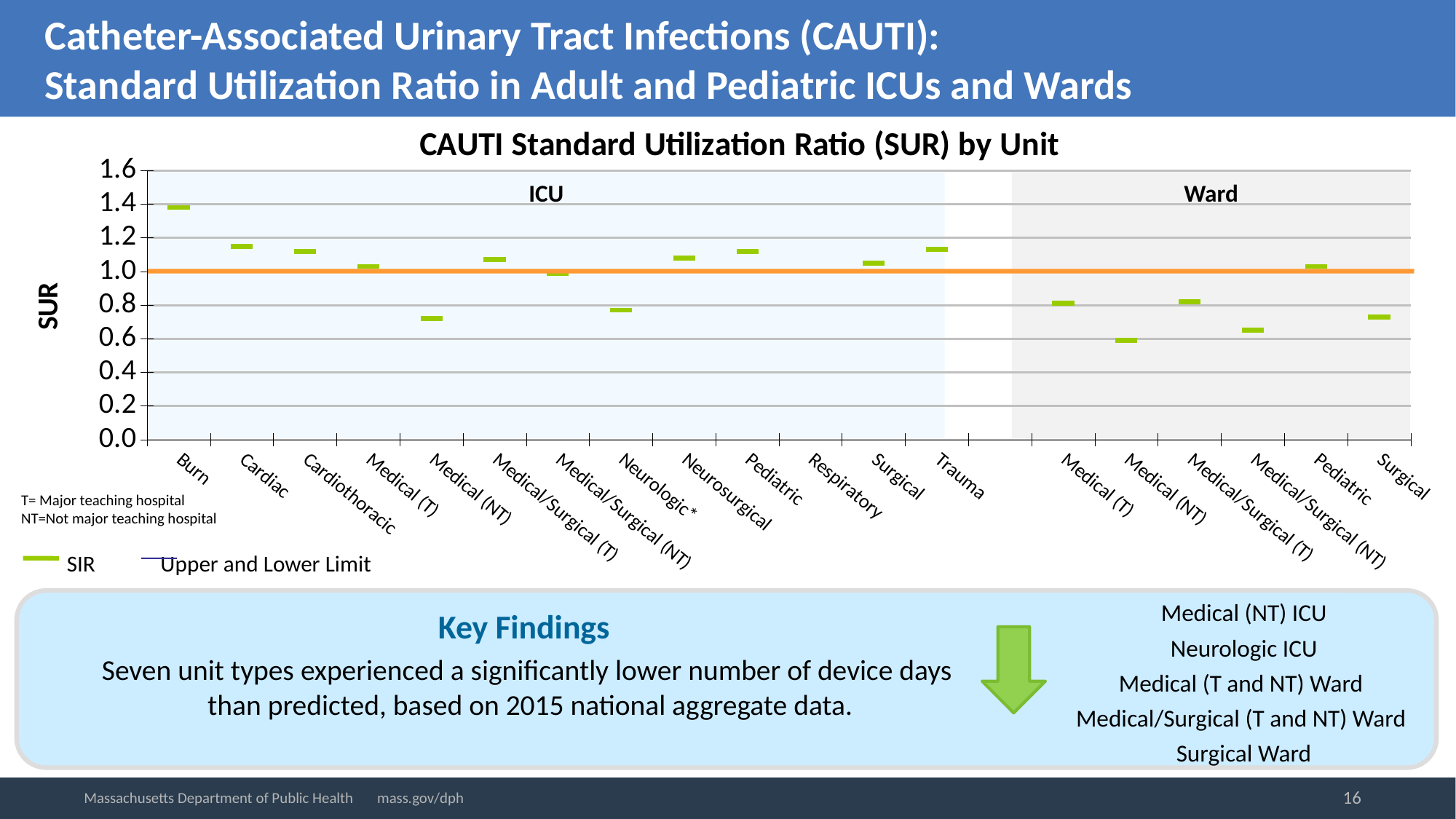
Which unit has the lowest SUR value on the chart? Medical (NT) Ward Is the SUR value for the Medical/Surgical (NT) Ward greater or less than 0.8? less What is the title of the chart? CAUTI Standard Utilization Ratio (SUR) by Unit Which has the higher SUR value: the Neurologic ICU or the Neurosurgical ICU? Neurosurgical ICU Is the SUR value for the Medical (NT) ICU greater or less than 0.8? less At what SUR value is the horizontal orange reference line drawn? 1.0 Is the SUR value for the Burn ICU greater or less than 1.2? greater Which has the higher SUR value: the Pediatric Ward or the Surgical Ward? Pediatric Ward Which unit has the highest SUR value on the chart? Burn (ICU) How many entries does the chart legend list? 2 How many unit categories are labeled on the x axis of the chart? 19